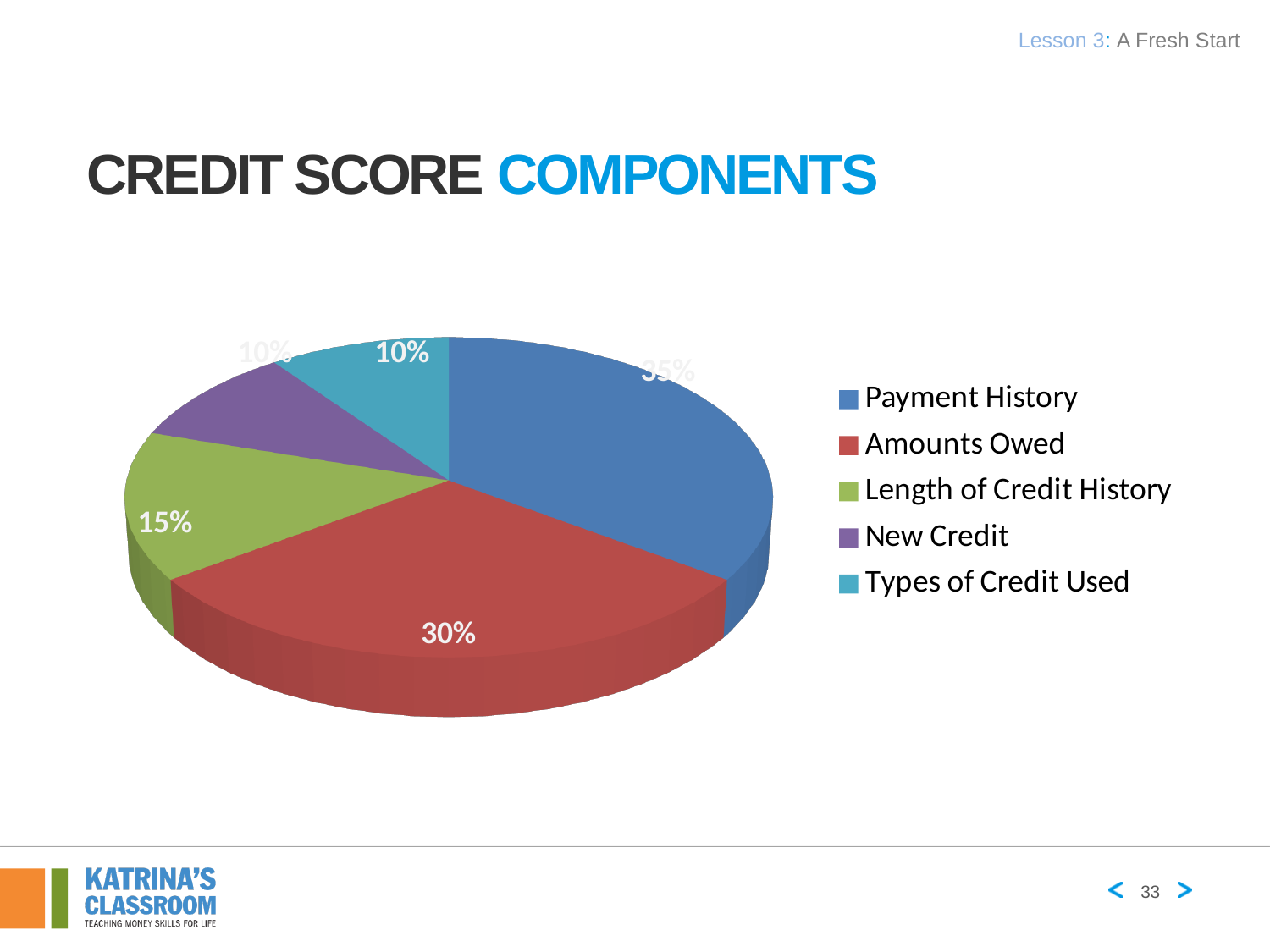
Which component has the largest share of the pie? Payment History What percentage of the credit score is Amounts Owed? 30% How many percentage points larger is Amounts Owed than Length of Credit History? 15% How many percentage points larger is Payment History than Amounts Owed? 5% How many slices does the pie chart have? 5 How many entries does the legend list? 5 What percentage of the credit score is Types of Credit Used? 10% Which is larger, the share for Amounts Owed or the share for Length of Credit History? Amounts Owed What colour is the Amounts Owed slice? red What kind of chart is shown on the slide? pie chart What percentage of the credit score is Length of Credit History? 15% What percentage of the credit score is Payment History? 35%